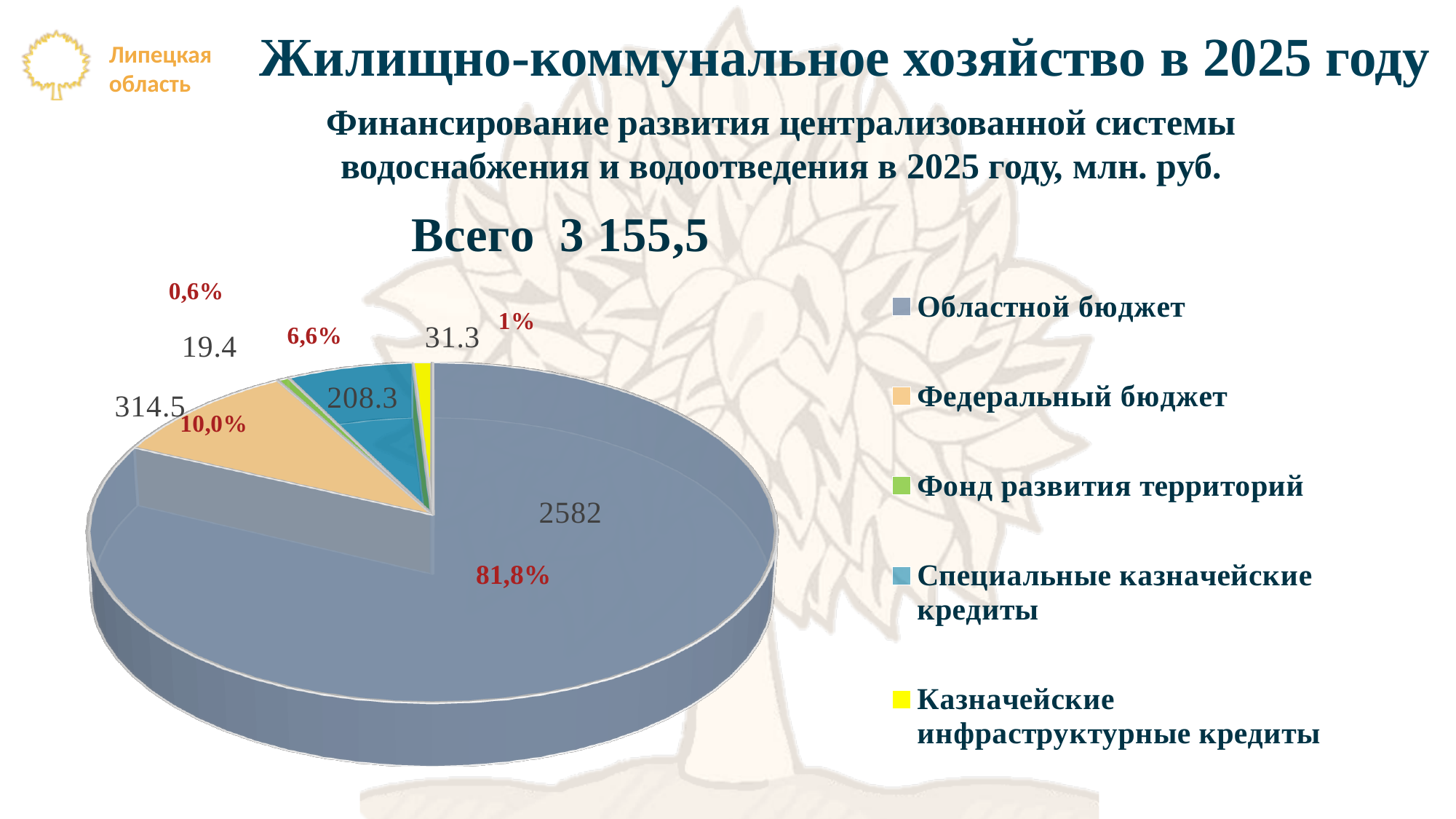
What kind of chart is shown on the slide? pie chart What share of the pie does Федеральный бюджет take? 10,0% What is the value for Фонд развития территорий? 19.4 What is the value for Казначейские инфраструктурные кредиты? 31.3 What is the value for Областной бюджет? 2582 Which is larger, Федеральный бюджет or Специальные казначейские кредиты? Федеральный бюджет Which category has the smallest slice? Фонд развития территорий How many categories does the legend list? 5 What is the value for Специальные казначейские кредиты? 208.3 What share of the pie does Областной бюджет take? 81,8% Which category has the largest slice? Областной бюджет What is the value for Федеральный бюджет? 314.5